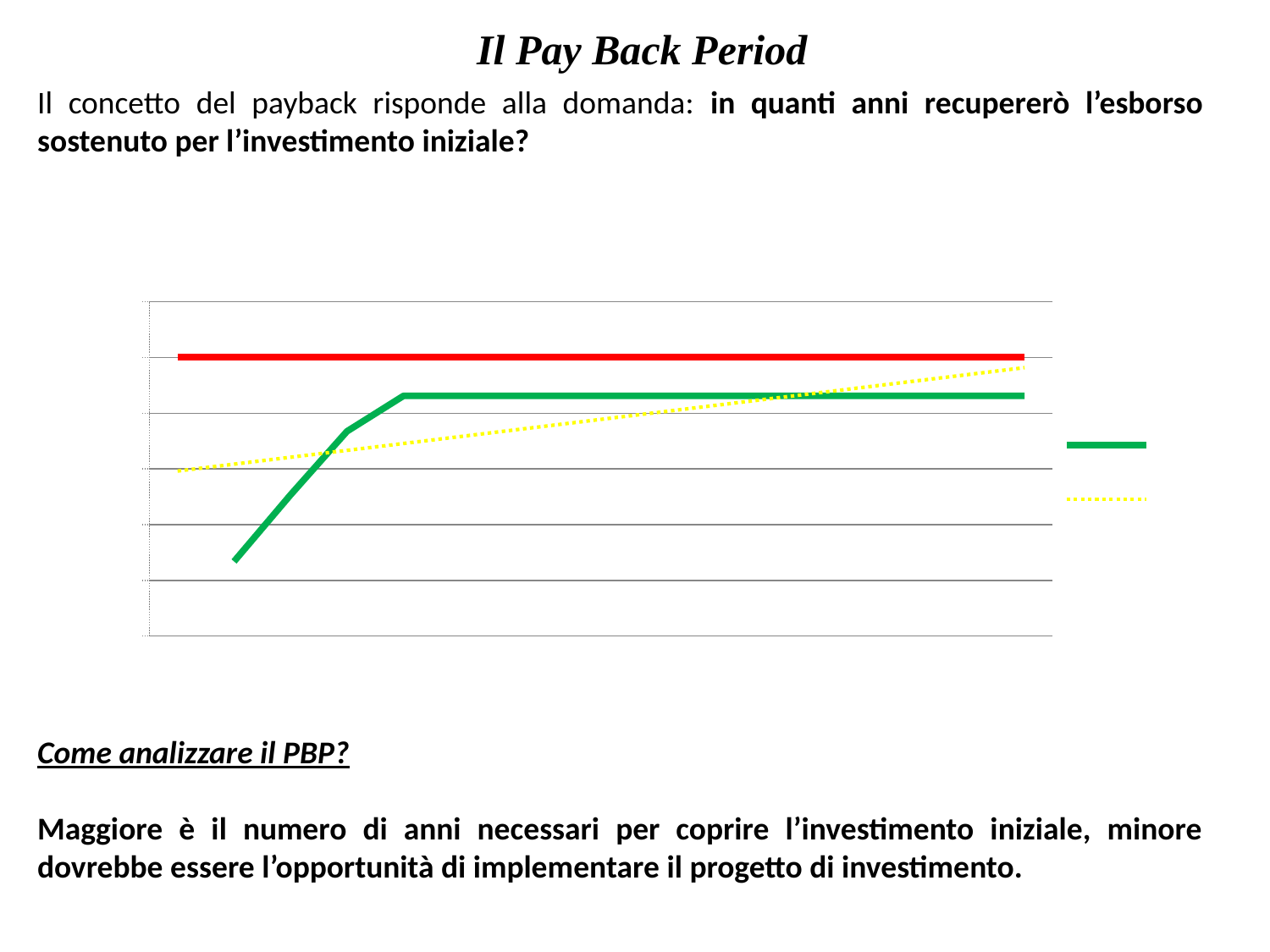
What colour is the dotted line in the chart? yellow Does the yellow dotted line rise or fall from left to right? rise At the left end of the chart, which is higher, the green line or the yellow dotted line? the yellow dotted line How many entries does the chart's legend show? 2 What colour is the horizontal line at the top of the chart? red Does the solid green line rise or fall from left to right before it flattens out? rise How many lines are plotted in the chart? 3 What kind of chart is shown on the slide? line chart Which line in the chart stays flat across its whole length? the red line Which line is higher at the right edge of the chart, the red line or the green line? the red line